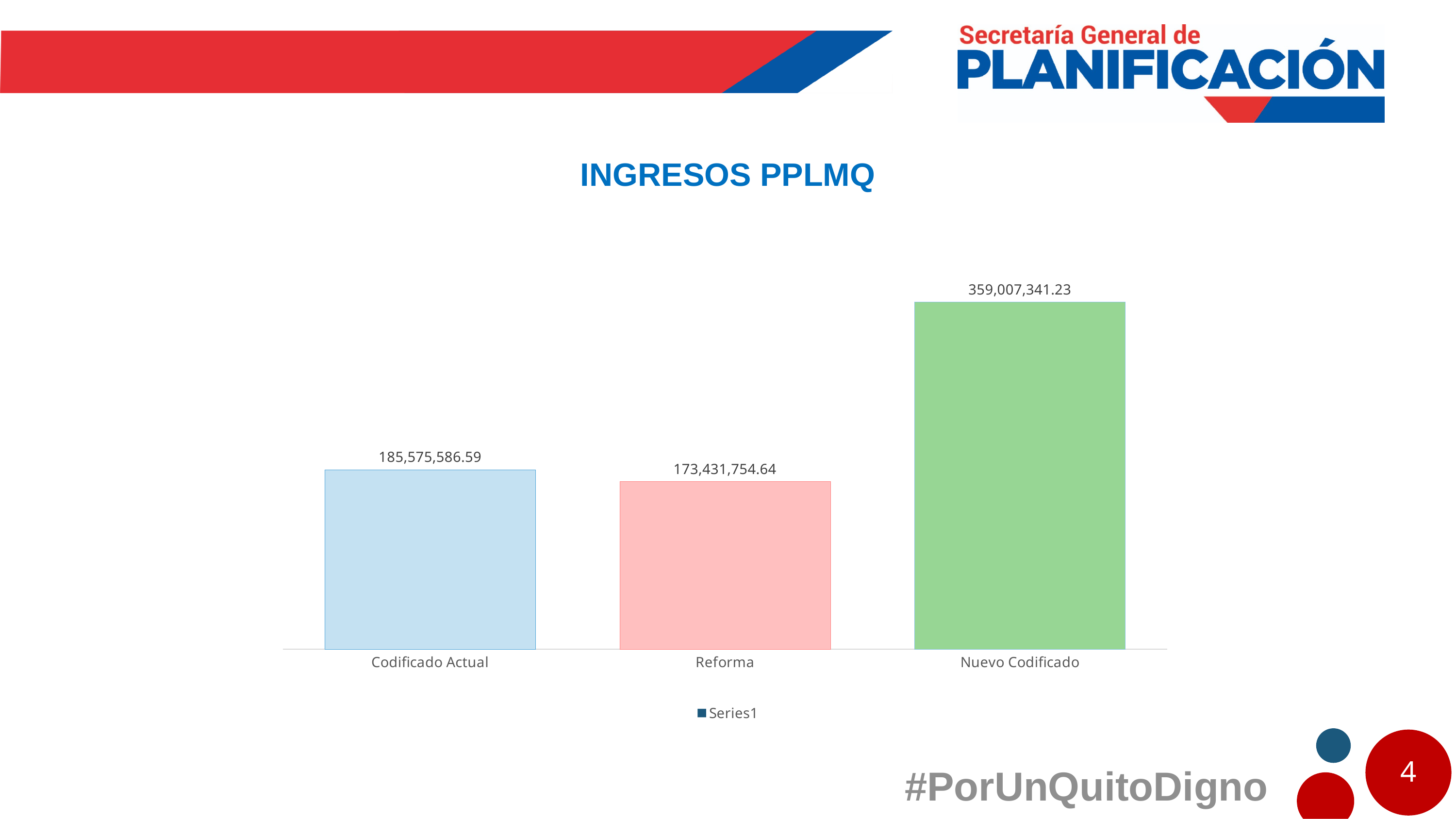
What is the difference between the values for Codificado Actual and Reforma? 12,143,831.95 Which category has the highest value? Nuevo Codificado How many categories are shown on the x axis? 3 What is the title of the chart? INGRESOS PPLMQ What is the value for Reforma? 173,431,754.64 What is the value for Nuevo Codificado? 359,007,341.23 How many series does the legend list? 1 What is the difference between the values for Nuevo Codificado and Codificado Actual? 173,431,754.64 Which category has the lowest value? Reforma What is the value for Codificado Actual? 185,575,586.59 What kind of chart is shown on the slide? Bar chart Which is larger, the value for Codificado Actual or the value for Reforma? Codificado Actual